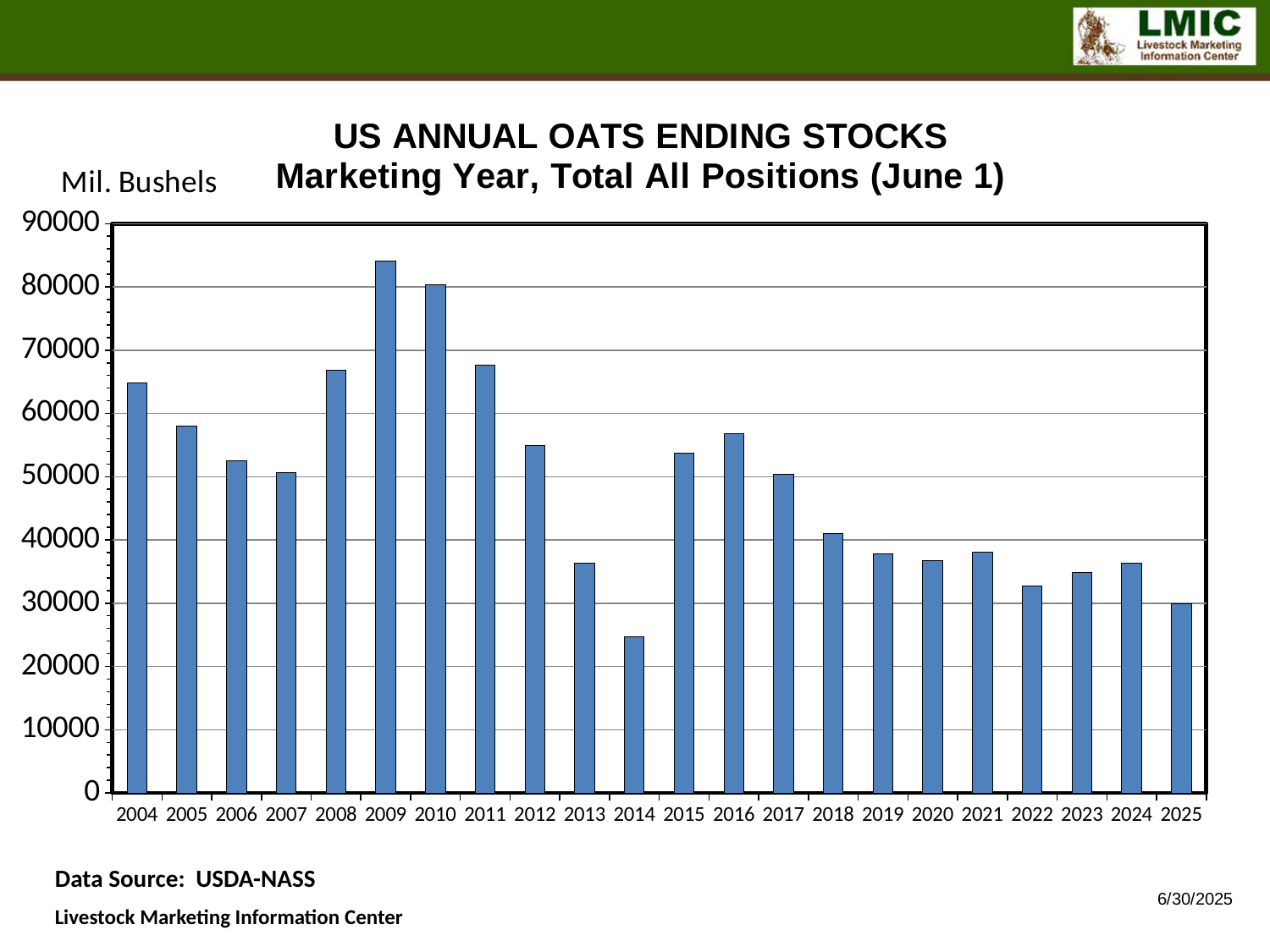
Is the value for 2013 greater or less than 40000? less What unit is shown for the vertical axis? Mil. Bushels Which year has the highest oats ending stocks? 2009 Is the value for 2004 greater or less than 60000? greater Which year has the larger value, 2005 or 2006? 2005 Which year has the lowest oats ending stocks? 2014 Is the value for 2014 greater or less than 30000? less How many years are plotted on the chart? 22 Which year has the larger value, 2024 or 2025? 2024 Do the values rise or fall from 2009 to 2014? fall What kind of chart is shown on the slide? bar chart